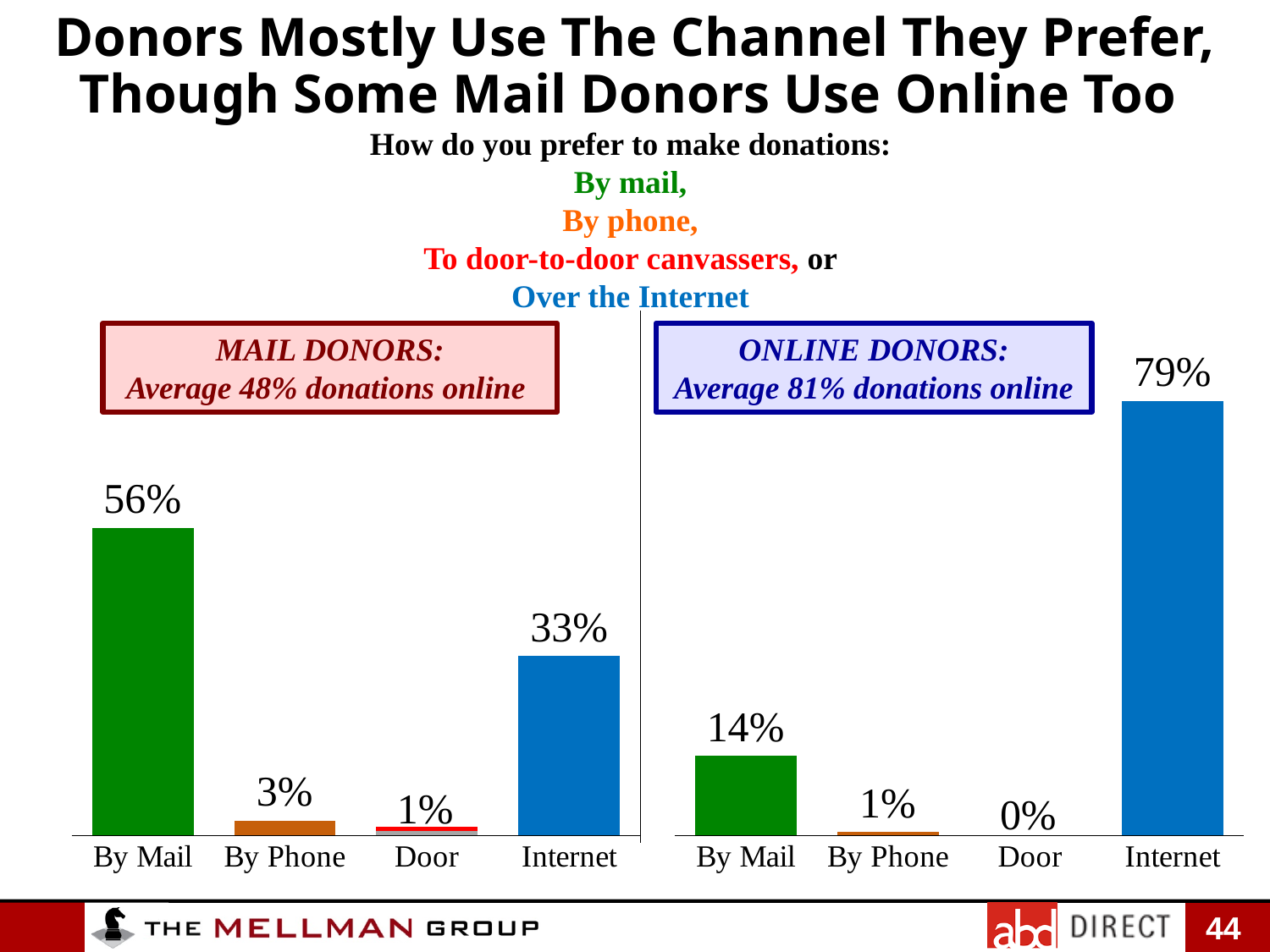
In the Mail Donors chart, what is the difference between the By Mail and Internet values? 23% In the Online Donors chart, what is the value for By Mail? 14% In the Mail Donors chart, which channel has the highest value? By Mail In the Mail Donors chart, what percentage prefer to donate by mail? 56% In the Mail Donors chart, what is the value for Internet? 33% In the Mail Donors chart, what is the value for Door? 1% In the Online Donors chart, what percentage prefer to donate over the Internet? 79% How many channel categories are shown in the Online Donors chart? 4 In the Online Donors chart, what is the difference between the Internet and By Mail values? 65% What type of chart is the Mail Donors chart? Bar chart Which is larger: the Internet value in the Mail Donors chart or the Internet value in the Online Donors chart? Online Donors In the Online Donors chart, which channel has the lowest value? Door